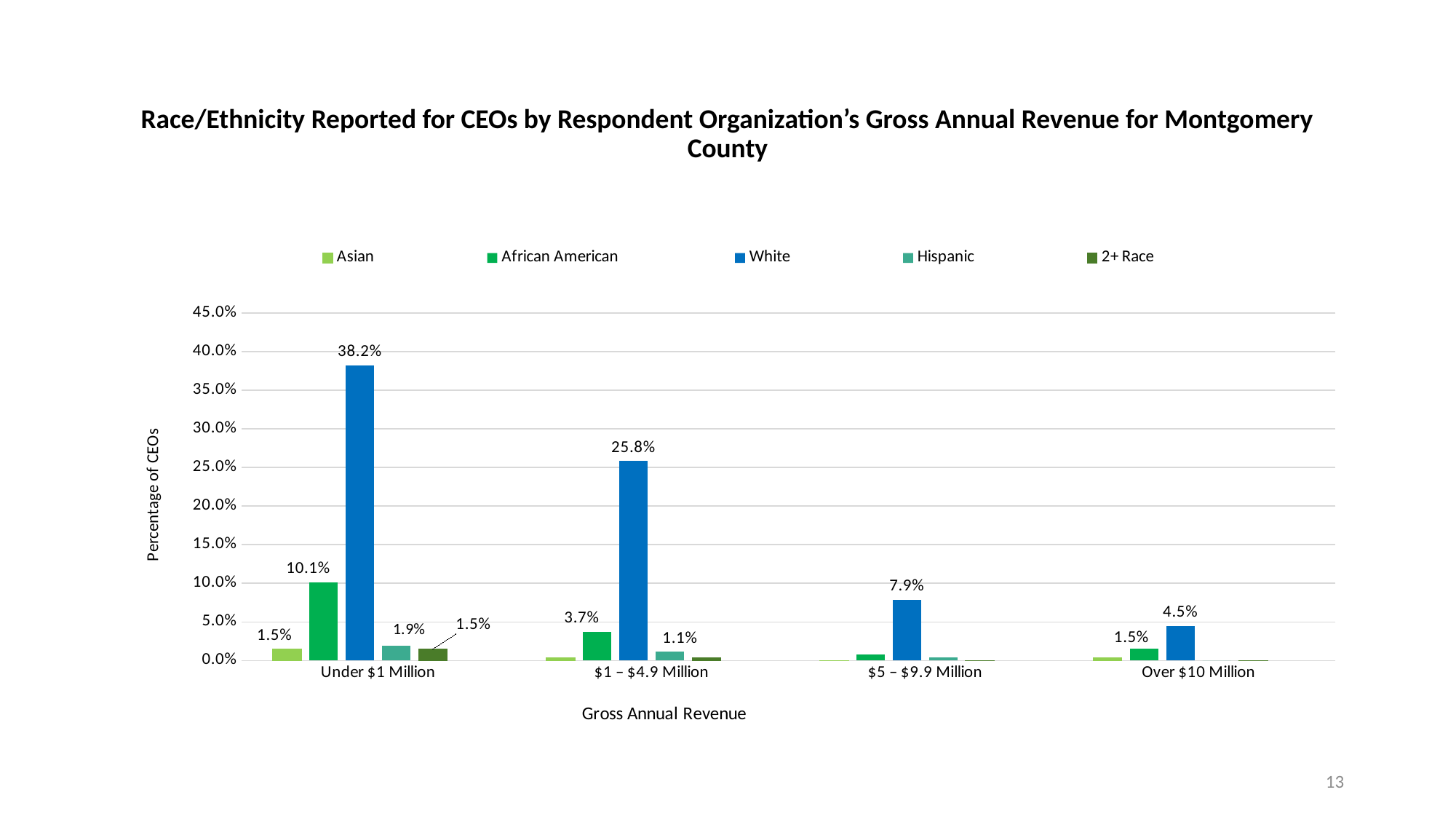
What is the difference between the White percentage for Under $1 Million and for $1 – $4.9 Million? 12.4% What is the value for White CEOs in the Over $10 Million revenue category? 4.5% Which revenue category has the highest percentage of White CEOs? Under $1 Million How many race/ethnicity series does the legend list? 5 Is the value for White CEOs in the $5 – $9.9 Million category greater or less than 10.0%? less What percentage of CEOs are White for organizations with gross annual revenue Under $1 Million? 38.2% How many gross annual revenue categories are shown on the x axis? 4 What kind of chart is shown on the slide? Bar chart In the Under $1 Million category, which is larger: the African American value or the Hispanic value? African American What percentage of CEOs are White in the $1 – $4.9 Million revenue category? 25.8% What is the value for African American CEOs in the Under $1 Million revenue category? 10.1% Do the values for White CEOs rise or fall as gross annual revenue increases along the x axis? Fall